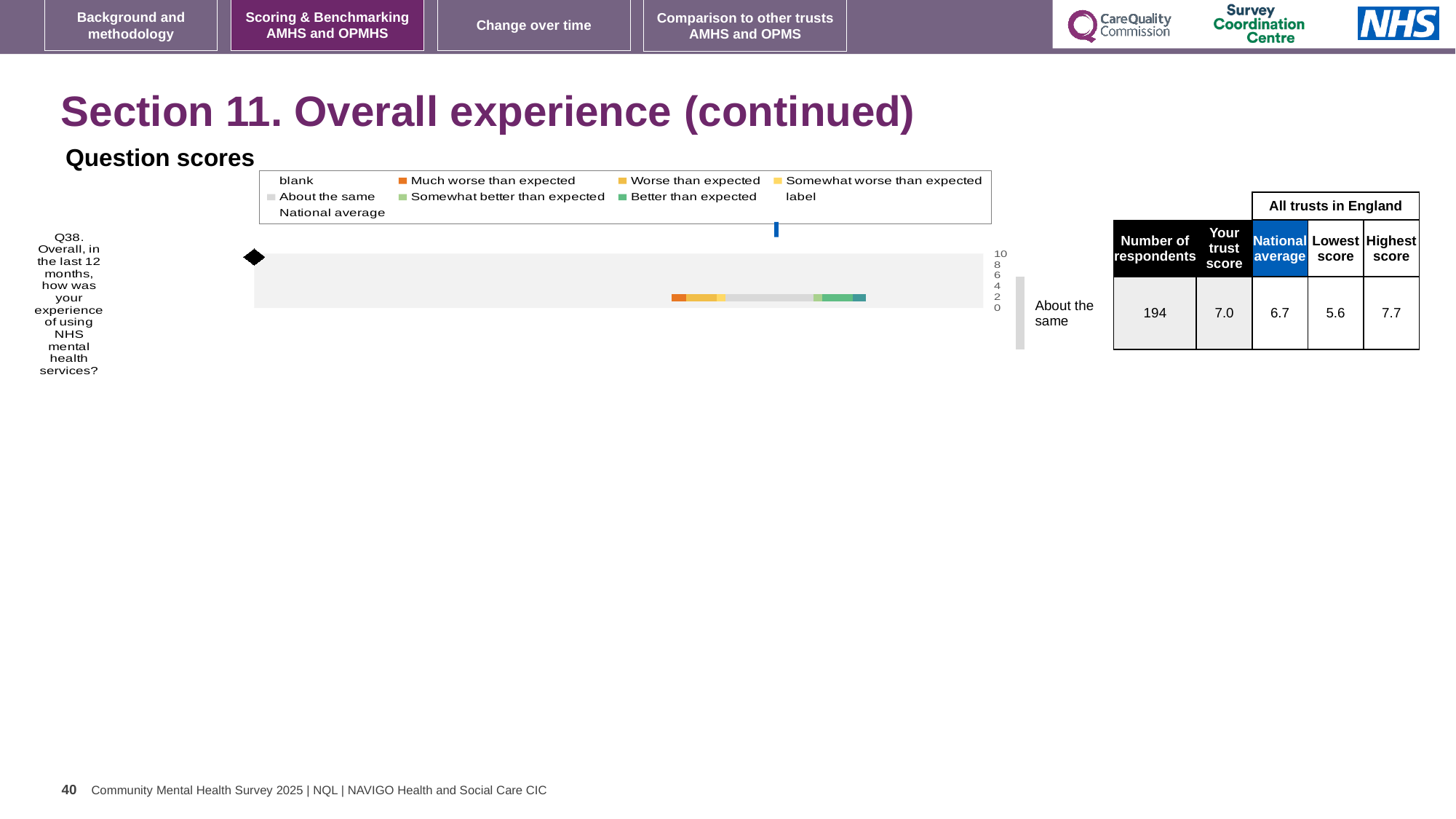
What benchmark category label is shown next to the bar for Q38? About the same In the table beside the chart, what is the trust score for Q38? 7.0 In the table beside the chart, what is the number of respondents for Q38? 194 In the Question scores chart legend, which colour represents 'Much worse than expected'? orange In the table beside the chart, what is the national average for Q38? 6.7 What is the highest tick value shown on the axis of the Question scores chart? 10 What kind of chart is shown under 'Question scores'? bar chart Which question is plotted in the Question scores chart? Q38. Overall, in the last 12 months, how was your experience of using NHS mental health services? In the table beside the chart, what is the difference between the highest score and the lowest score for Q38? 2.1 How many questions (categories) are plotted in the Question scores chart? 1 In the table beside the chart, is the trust score for Q38 larger or smaller than the national average? larger